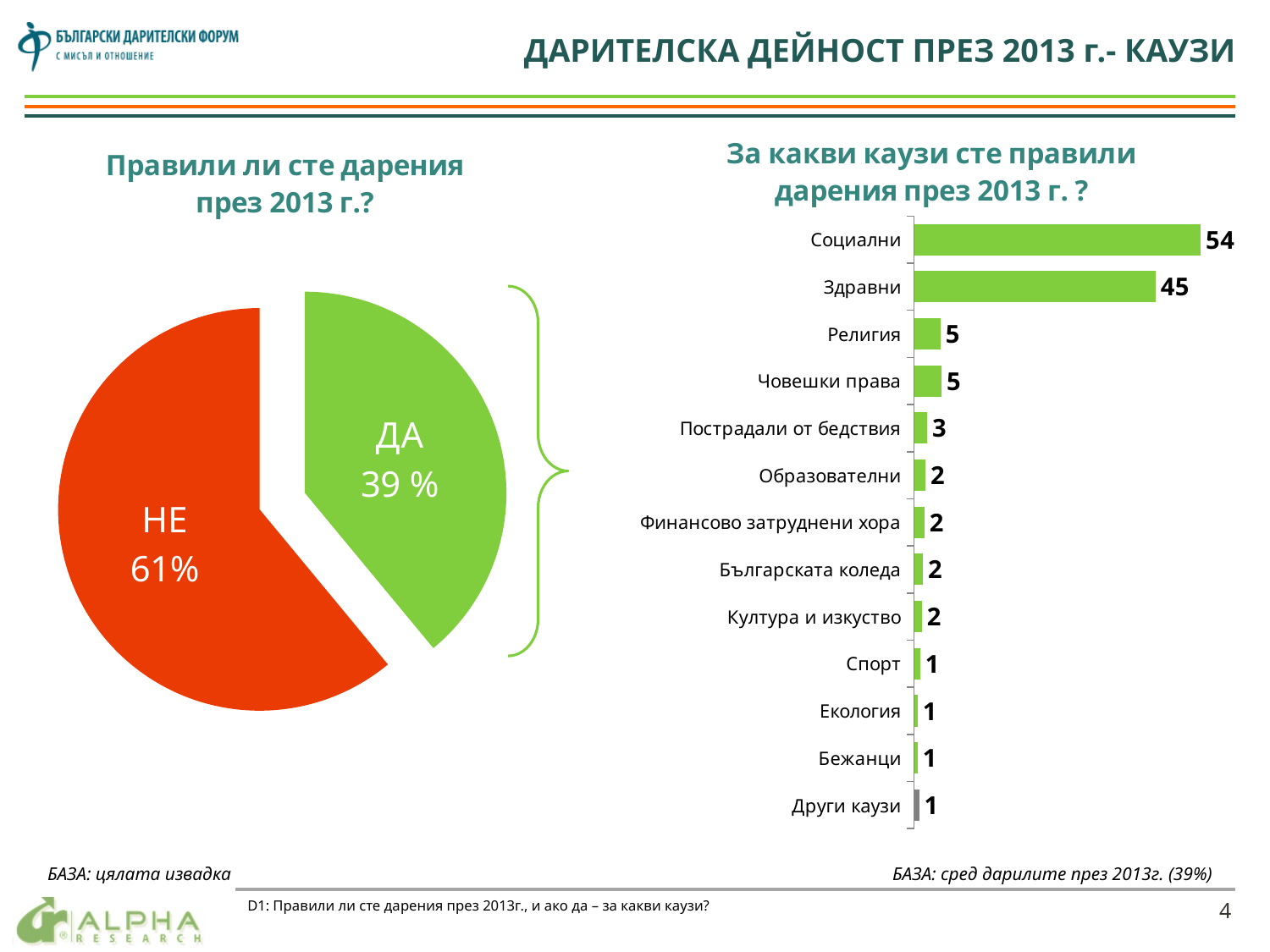
In the bar chart 'За какви каузи сте правили дарения през 2013 г. ?', what is the difference between the values for 'Социални' and 'Здравни'? 9 In the bar chart 'За какви каузи сте правили дарения през 2013 г. ?', which is larger, the value for 'Религия' or the value for 'Образователни'? Религия What type of chart is the chart on the left of the slide? Pie chart How many categories are shown in the bar chart 'За какви каузи сте правили дарения през 2013 г. ?'? 13 In the bar chart 'За какви каузи сте правили дарения през 2013 г. ?', what is the value for 'Пострадали от бедствия'? 3 In the pie chart 'Правили ли сте дарения през 2013 г.?', what share is labelled 'ДА'? 39 % In the bar chart 'За какви каузи сте правили дарения през 2013 г. ?', which category has the highest value? Социални In the bar chart 'За какви каузи сте правили дарения през 2013 г. ?', what is the value for 'Социални'? 54 What type of chart is the chart titled 'За какви каузи сте правили дарения през 2013 г. ?'? Bar chart In the pie chart 'Правили ли сте дарения през 2013 г.?', what share is labelled 'НЕ'? 61% In the pie chart 'Правили ли сте дарения през 2013 г.?', which slice is larger, 'ДА' or 'НЕ'? НЕ In the bar chart 'За какви каузи сте правили дарения през 2013 г. ?', what is the value for 'Здравни'? 45